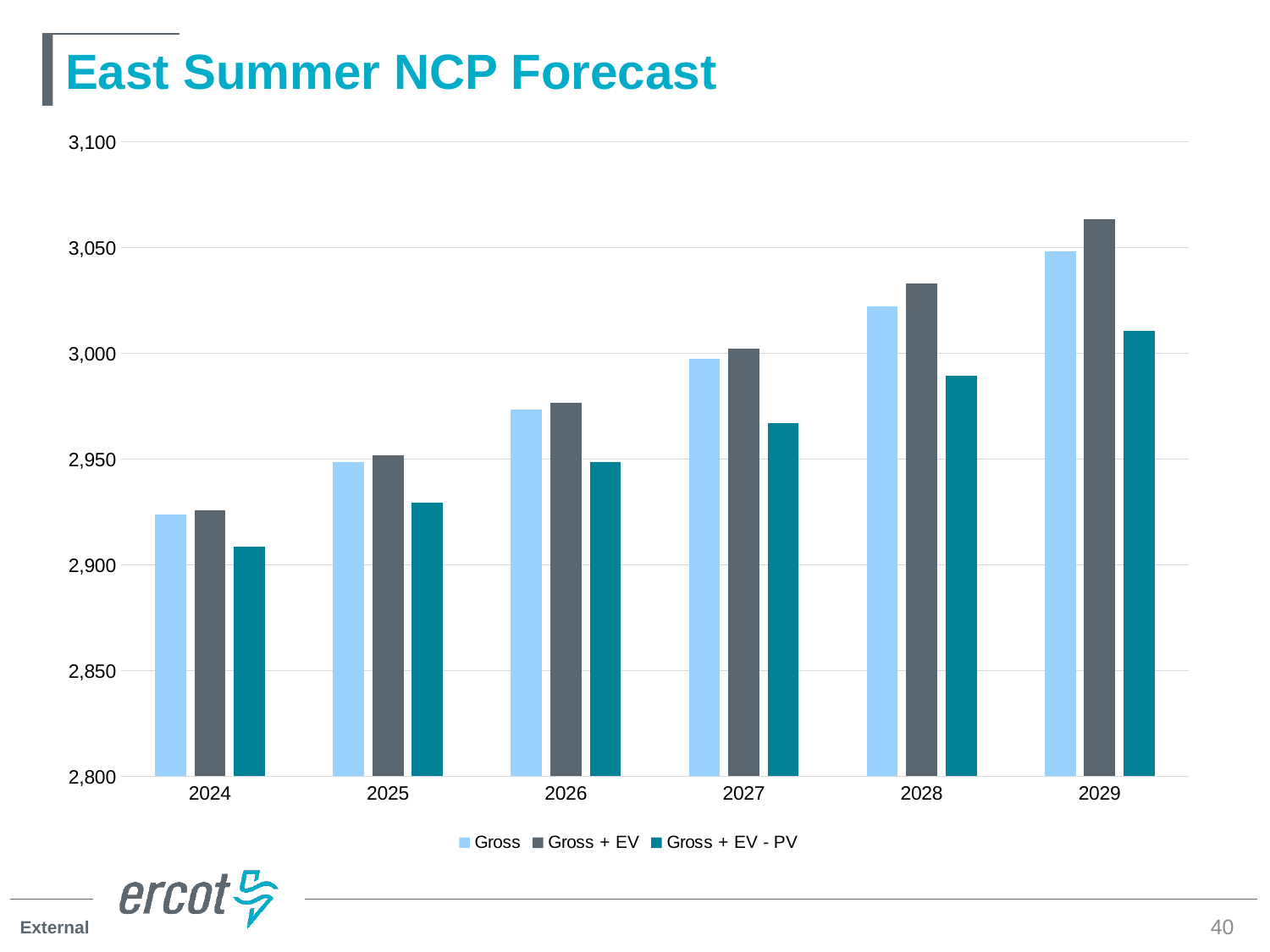
What kind of chart is shown on the slide? Bar chart Is the Gross + EV - PV value for 2025 greater or less than 2,950? less What is the title of the chart? East Summer NCP Forecast Which series and year has the lowest bar in the chart? Gross + EV - PV in 2024 Which series and year has the highest bar in the chart? Gross + EV in 2029 Is the Gross + EV value for 2029 greater or less than 3,050? greater In 2028, which is larger: Gross + EV or Gross + EV - PV? Gross + EV How many series does the legend list? 3 Is the Gross + EV - PV value for 2027 greater or less than 3,000? less How many years are shown on the x axis? 6 Do the Gross values rise or fall from 2024 to 2029? Rise